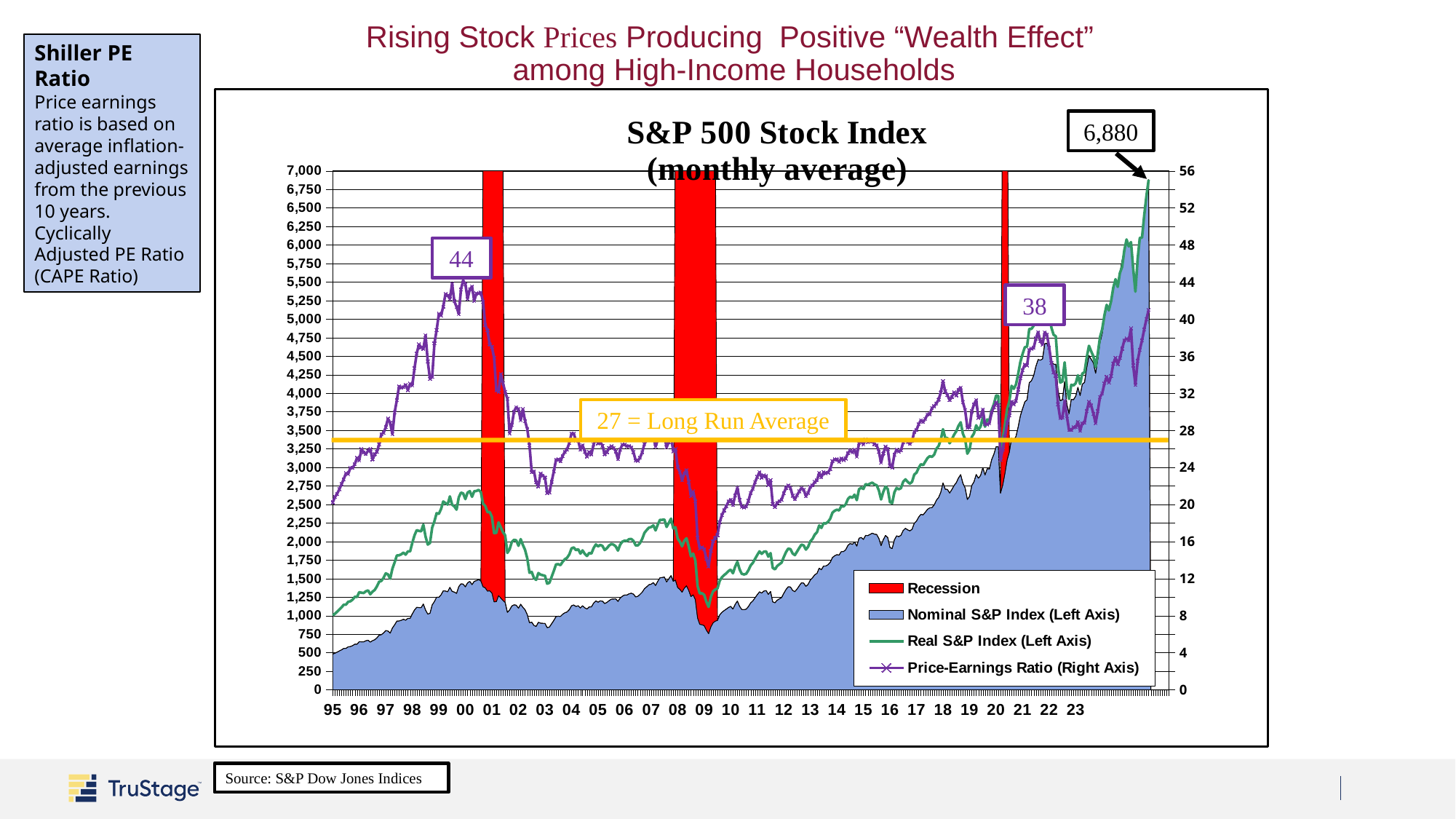
What peak value of the Price-Earnings Ratio is labeled around 2000? 44 What is the latest value of the Nominal S&P Index labeled on the chart? 6,880 What is the difference between the labeled Price-Earnings Ratio peaks of 44 and 38? 6 What is the title of the chart on the slide? S&P 500 Stock Index (monthly average) Does the Nominal S&P Index generally rise or fall from 1995 to the end of the chart? rise How many recession periods are shaded on the chart? 3 What peak value of the Price-Earnings Ratio is labeled around 2021? 38 Which labeled Price-Earnings Ratio peak is larger, the one around 2000 or the one around 2021? The one around 2000 (44) How many series does the chart's legend list? 4 By how much does the labeled Price-Earnings Ratio peak of 44 exceed the long run average of 27? 17 Is the Nominal S&P Index at its 2009 low greater or less than 1,000? less What value is given as the long run average of the Price-Earnings Ratio? 27